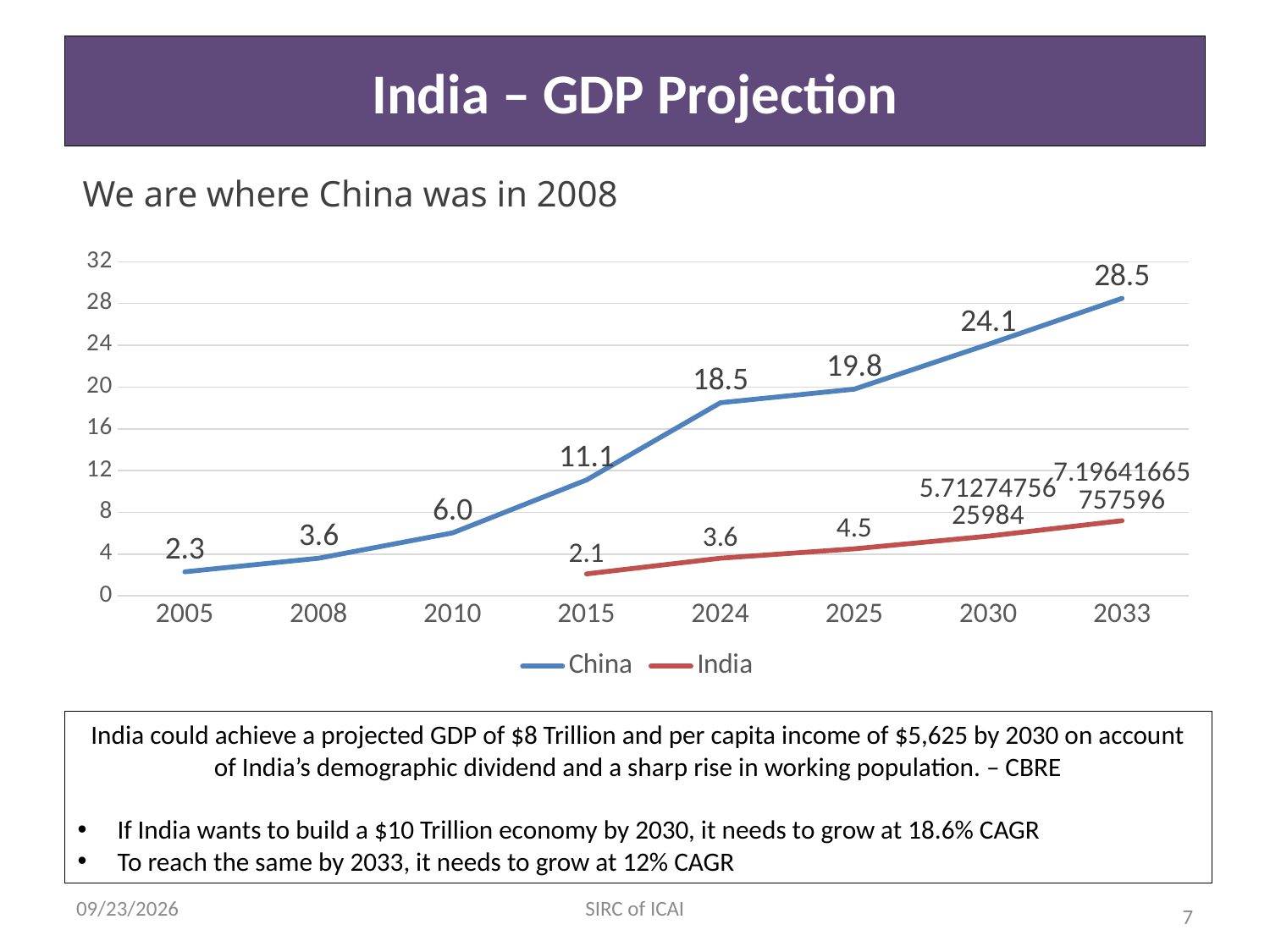
Which series has the larger value in 2030, China or India? China How many series does the chart legend list? 2 What is the difference between the China and India values in 2024? 14.9 In which year does the China series reach its highest value? 2033 Is the value for India in 2030 greater or less than 8? less What is the difference between the China values for 2033 and 2030? 4.4 What type of chart is shown on the slide? line chart How many years are shown on the x axis of the chart? 8 What is the value for India in 2025? 4.5 What is the value for China in 2033? 28.5 In which year does the China series have its lowest value? 2005 What is the value for China in 2015? 11.1